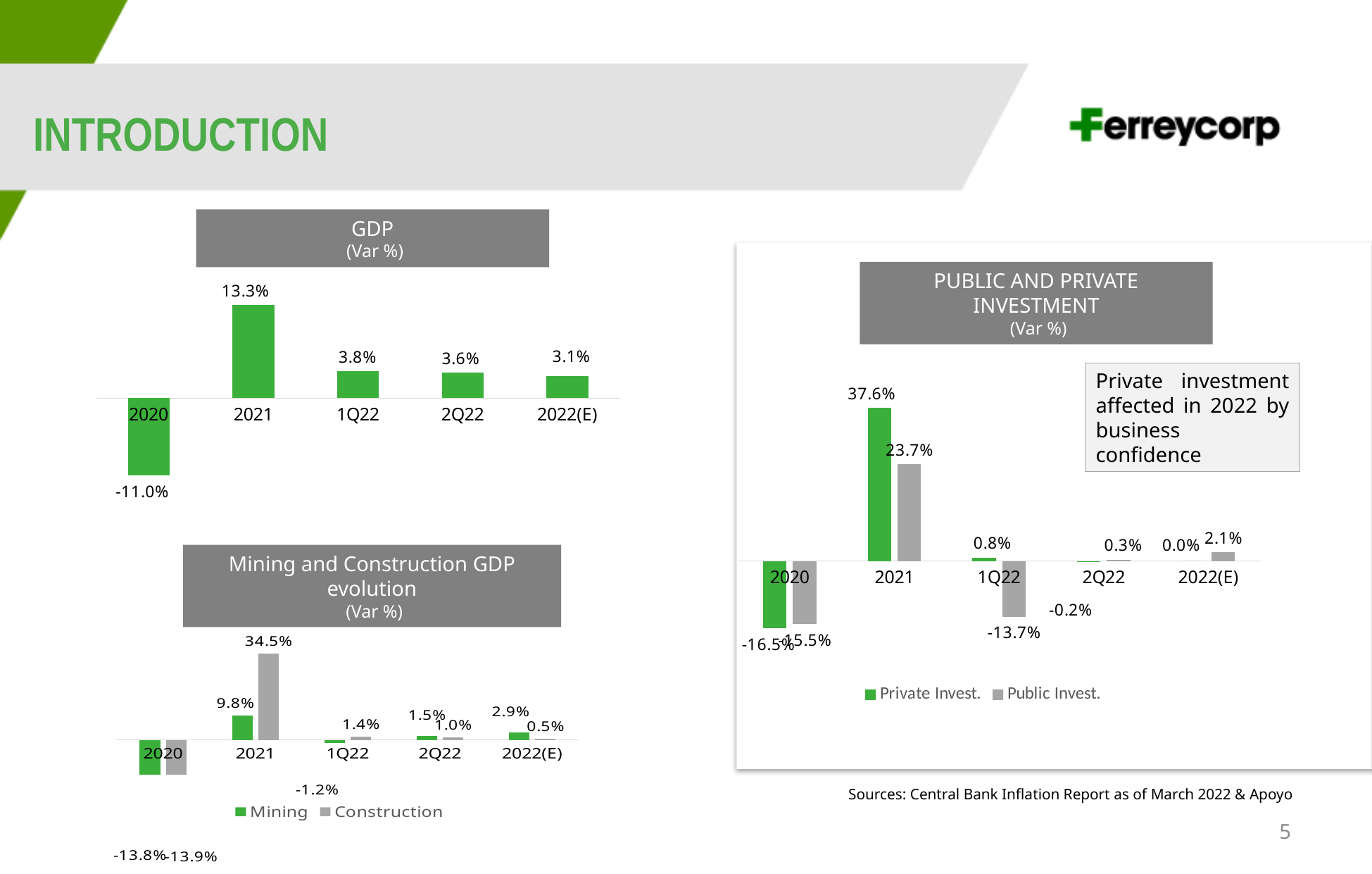
In the Mining and Construction GDP evolution chart, what is the Mining value for 1Q22? -1.2% In the GDP (Var %) chart, which period has the highest value? 2021 In the GDP (Var %) chart, what is the difference between the 2021 value and the 2022(E) value? 10.2% In the Public and Private Investment chart, what is the Private Invest. value for 2021? 37.6% In the Public and Private Investment chart, what is the Public Invest. value for 1Q22? -13.7% In the Mining and Construction GDP evolution chart, what is the Construction value for 2021? 34.5% In the Mining and Construction GDP evolution chart, how many series does the legend list? 2 In the Mining and Construction GDP evolution chart, which is larger for 2022(E): Mining or Construction? Mining In the GDP (Var %) chart, what is the value for 2021? 13.3% In the GDP (Var %) chart, what is the value for 2020? -11.0% In the GDP (Var %) chart, how many periods are shown on the x axis? 5 What type of chart is the Public and Private Investment chart? Bar chart